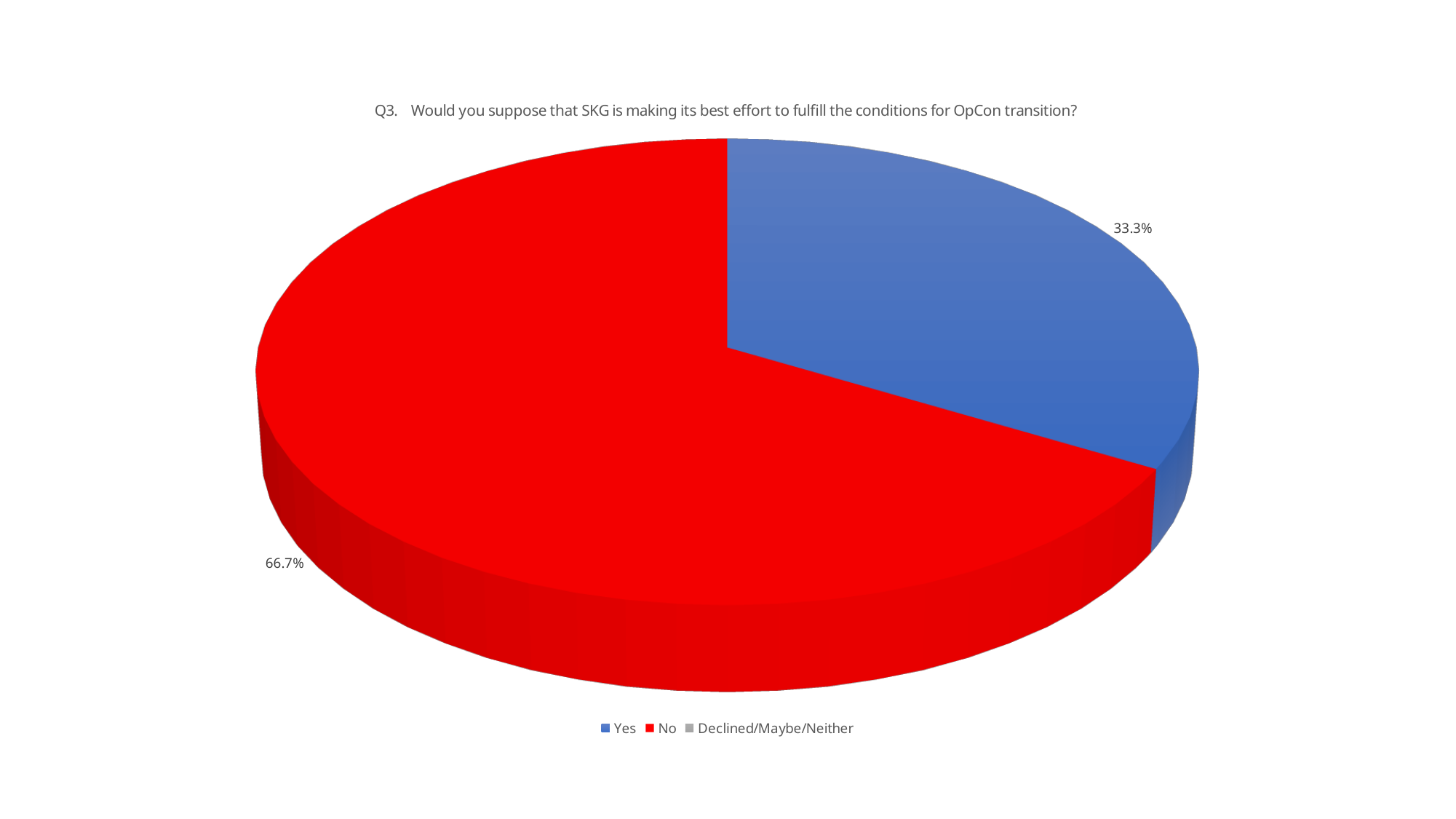
What is the title of the chart? Q3. Would you suppose that SKG is making its best effort to fulfill the conditions for OpCon transition? What percentage of respondents answered "Yes"? 33.3% What is the third legend entry, after "Yes" and "No"? Declined/Maybe/Neither How many entries does the legend list? 3 Which response has the largest share of the pie? No What colour is the "No" slice? Red What is the difference in percentage points between the "No" and "Yes" shares? 33.4 What percentage of respondents answered "No"? 66.7% Is the share for "Yes" greater or less than 50%? less What kind of chart is shown on the slide? Pie chart Which of the two visible slices is larger, "Yes" or "No"? No Is the share for "No" greater or less than 50%? greater